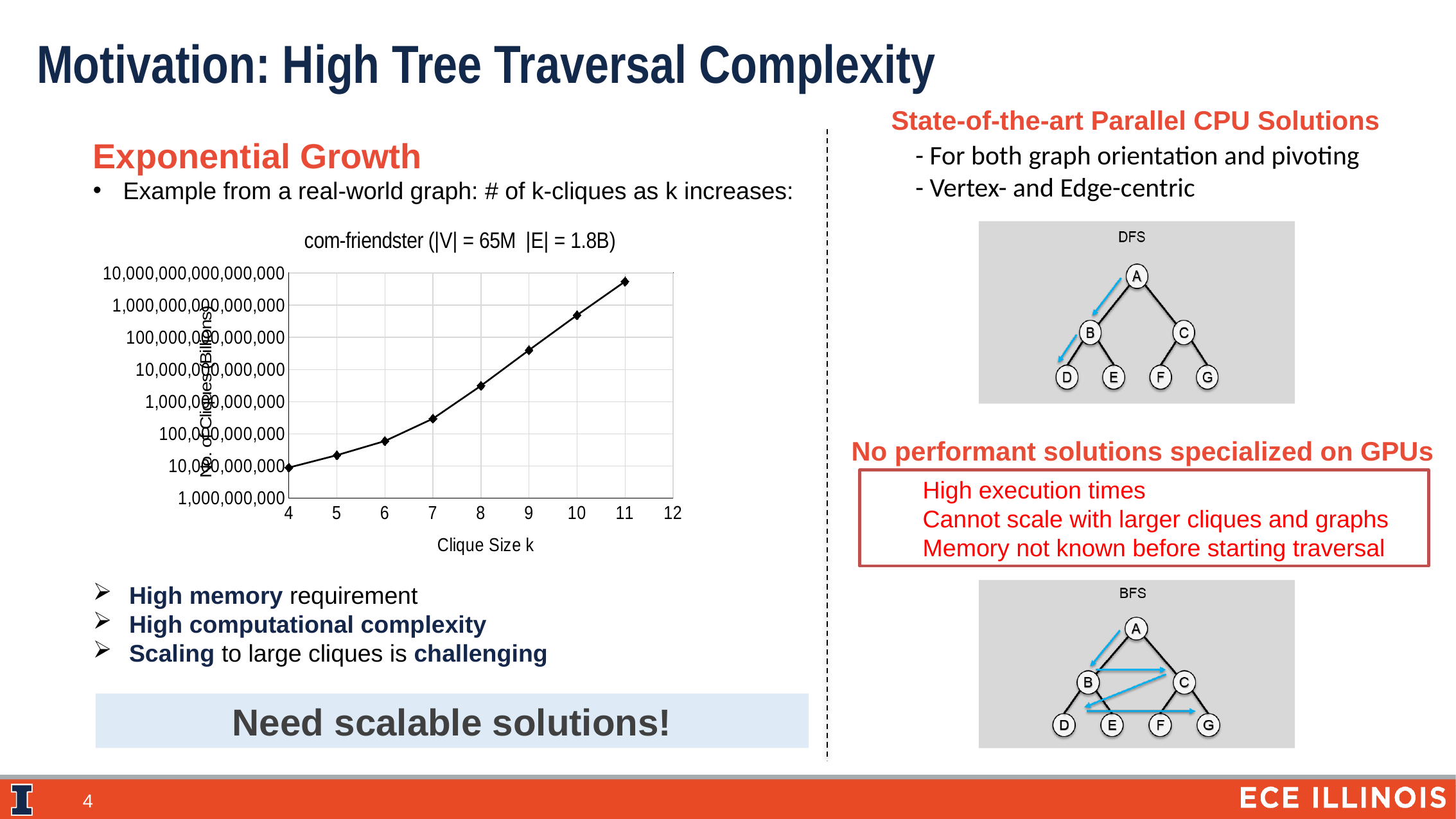
At which clique size k is the number of cliques highest? 11 What kind of chart is shown on the slide? line chart Is the value for clique size k = 11 greater or less than 1,000,000,000,000,000? greater At which clique size k is the number of cliques lowest? 4 Is the value for clique size k = 8 greater or less than 1,000,000,000,000? greater What is the title of the chart? com-friendster (|V| = 65M |E| = 1.8B) Do the values rise or fall as clique size k increases? rise What is the label of the x axis of the chart? Clique Size k Is the value for clique size k = 5 greater or less than 100,000,000,000? less How many data points are plotted on the chart? 8 Which has a larger number of cliques, clique size k = 7 or k = 9? k = 9